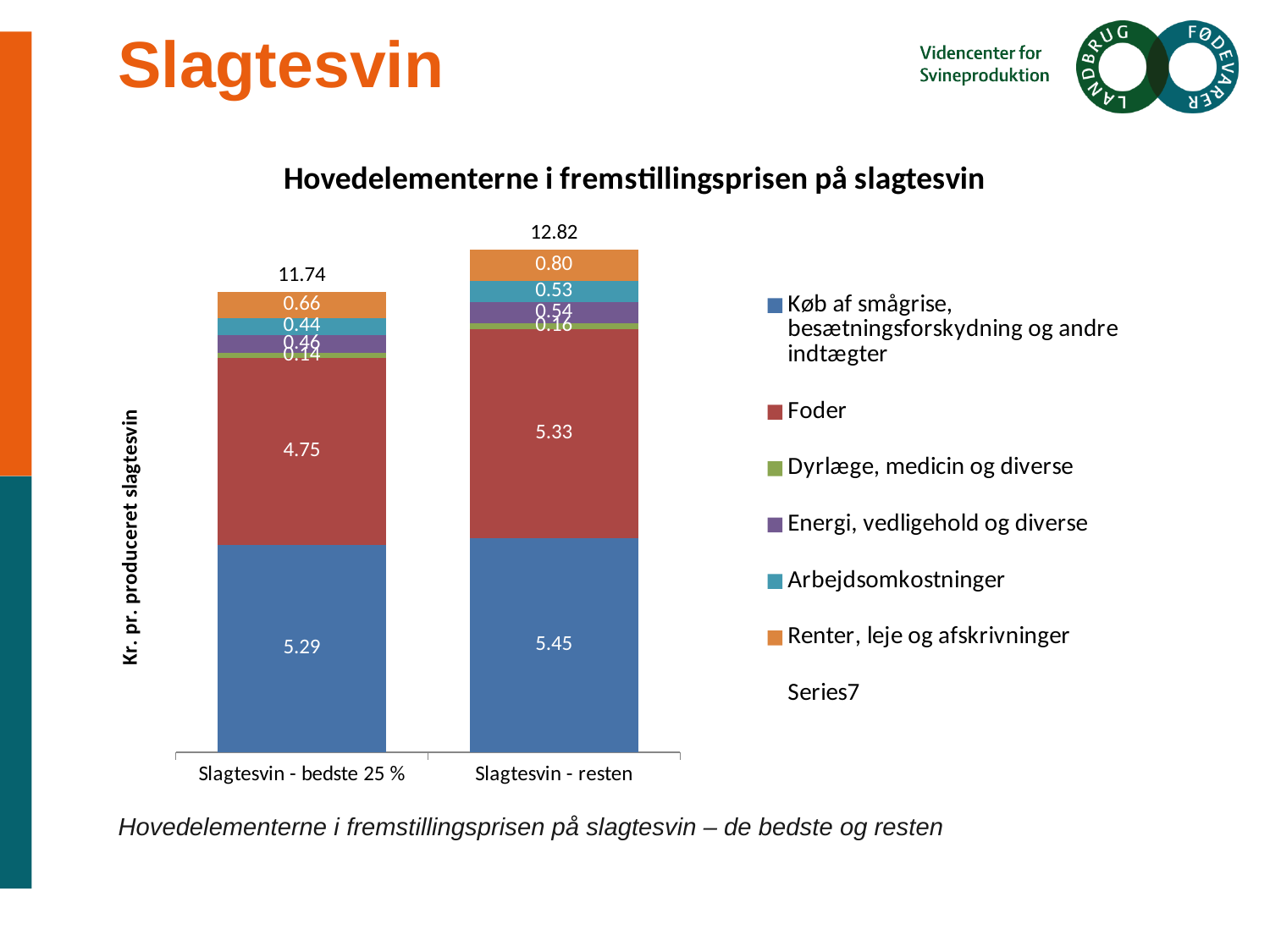
What is the total of the stacked bar for Slagtesvin - resten? 12.82 How many entries does the chart's legend list? 7 What kind of chart is shown on the slide? Stacked bar chart What is the value of Foder for Slagtesvin - resten? 5.33 What is the total of the stacked bar for Slagtesvin - bedste 25 %? 11.74 What is the title of the chart's vertical axis? Kr. pr. produceret slagtesvin What is the difference between the totals for Slagtesvin - resten and Slagtesvin - bedste 25 %? 1.08 What is the value of Renter, leje og afskrivninger for Slagtesvin - bedste 25 %? 0.66 How many categories are shown on the x axis of the chart? 2 Which category has the larger Foder value, Slagtesvin - bedste 25 % or Slagtesvin - resten? Slagtesvin - resten What is the value of Foder for Slagtesvin - bedste 25 %? 4.75 What is the value of Køb af smågrise, besætningsforskydning og andre indtægter for Slagtesvin - resten? 5.45